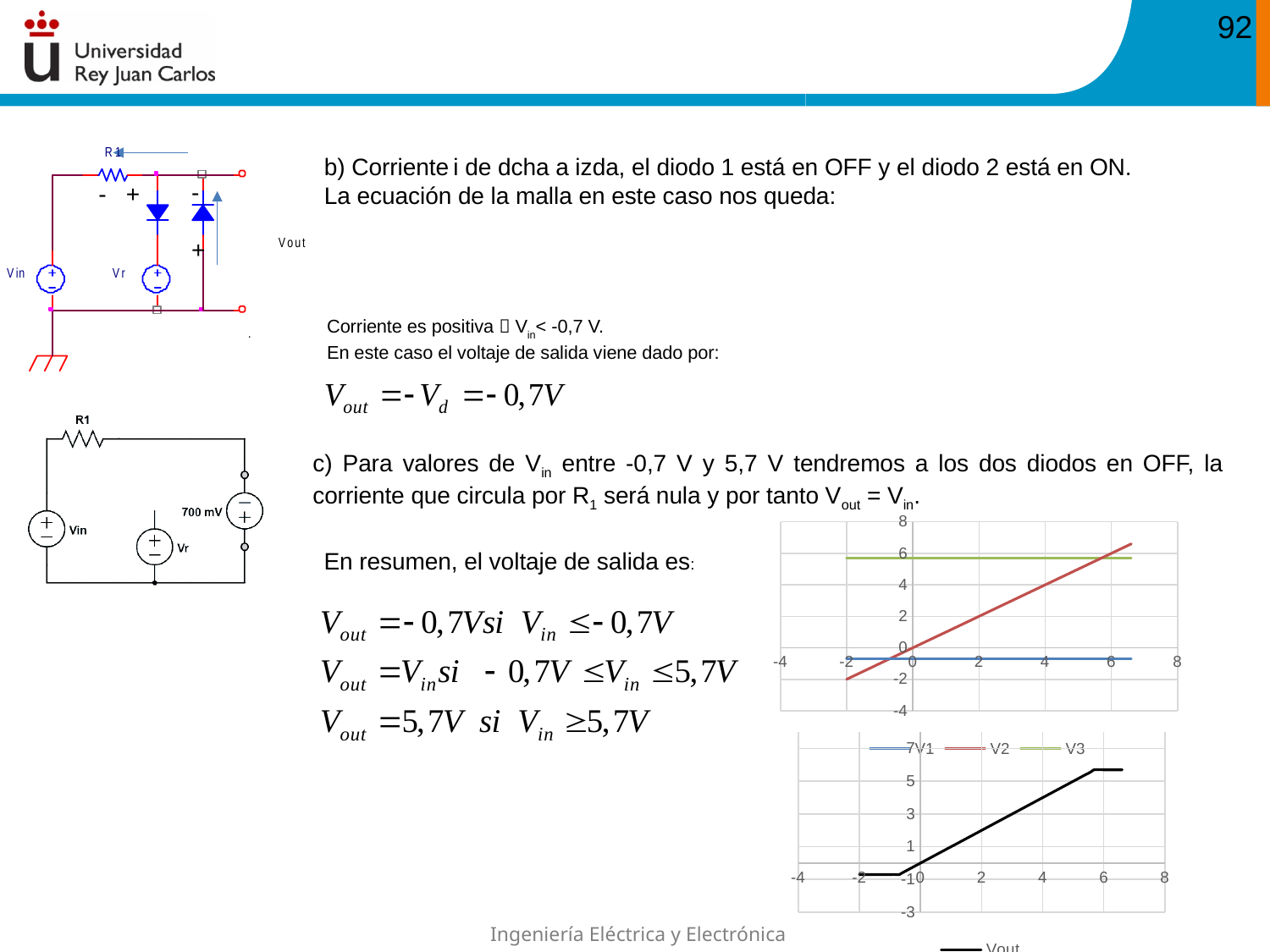
How many series does the legend of the top chart list? 3 What are the legend entries of the top chart? V1, V2, V3 How many series does the legend of the bottom chart list? 1 What is the legend entry of the bottom chart? Vout In the top chart, does the V1 series rise or fall as the x value increases? neither; it stays constant (flat) In the bottom chart, is the value of Vout at x = -2 greater or less than 1? less In the top chart, is the value of V3 greater or less than 4? greater In the bottom chart, does Vout rise or fall between x = 0 and x = 6? rise What kind of chart is the bottom chart on the right (with series Vout)? line chart What kind of chart is the top chart on the right (with series V1, V2, V3)? line chart